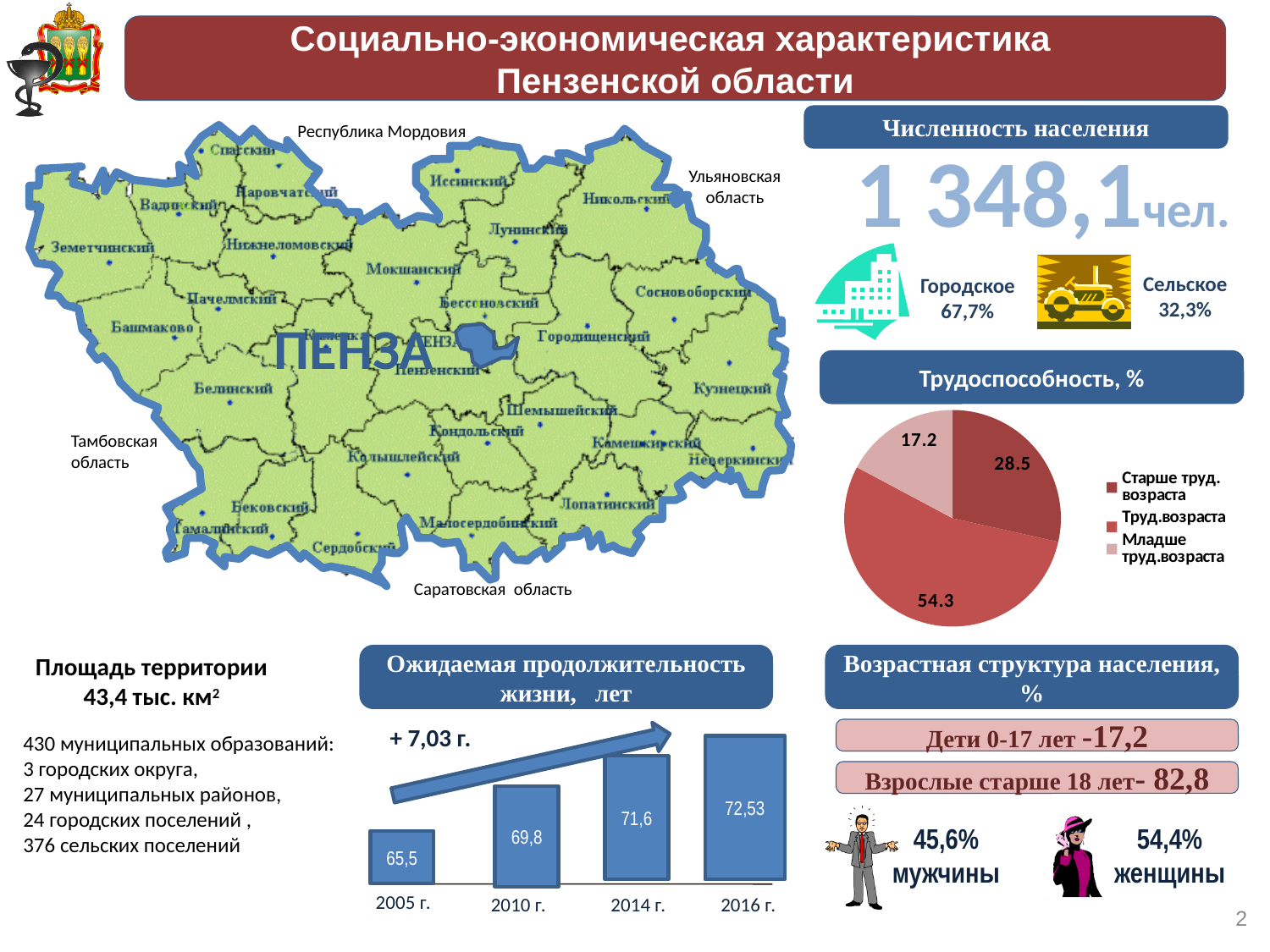
In the chart titled "Ожидаемая продолжительность жизни, лет", how many bars are shown? 4 In the chart titled "Трудоспособность, %", how many entries does the legend list? 3 In the chart titled "Трудоспособность, %", what is the difference between Труд.возраста and Старше труд. возраста? 25.8 In the chart titled "Ожидаемая продолжительность жизни, лет", what is the value for 2016 г.? 72,53 In the chart titled "Ожидаемая продолжительность жизни, лет", what is the difference between the 2016 г. and 2005 г. values? 7,03 In the chart titled "Трудоспособность, %", what is the value for Труд.возраста? 54.3 In the chart titled "Трудоспособность, %", what is the value for Старше труд. возраста? 28.5 In the chart titled "Ожидаемая продолжительность жизни, лет", do the values rise or fall from 2005 г. to 2016 г.? rise In the chart titled "Трудоспособность, %", which category has the smallest share? Младше труд.возраста In the chart titled "Ожидаемая продолжительность жизни, лет", what is the value for 2010 г.? 69,8 In the chart titled "Ожидаемая продолжительность жизни, лет", which year has the lowest value? 2005 г. What kind of chart is the chart titled "Трудоспособность, %"? pie chart